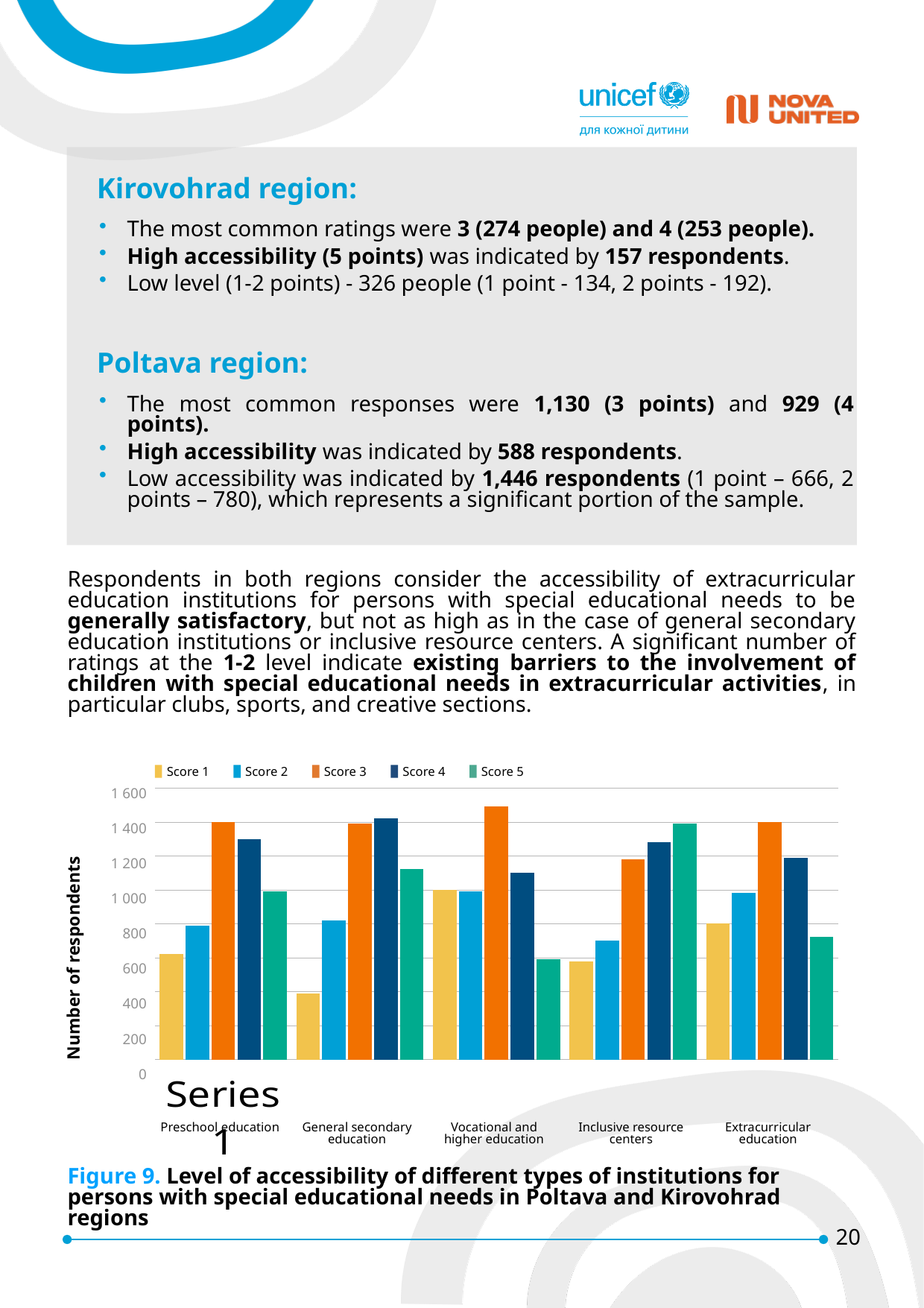
Is the Score 5 value for Vocational and higher education greater or less than 800? less Which series has the highest bar for Vocational and higher education? Score 3 Which series has the lowest bar for General secondary education? Score 1 What kind of chart is shown on the slide? bar chart For Preschool education, which is larger: the Score 3 bar or the Score 5 bar? Score 3 Which series is shown in orange in the chart legend? Score 3 Is the Score 3 value for Vocational and higher education greater or less than 1 400? greater Which series has the highest bar for Inclusive resource centers? Score 5 How many institution types (categories) are shown on the x axis of the chart? 5 What is the title of the vertical axis of the chart? Number of respondents Is the Score 1 value for General secondary education greater or less than 600? less How many series does the chart legend list? 5